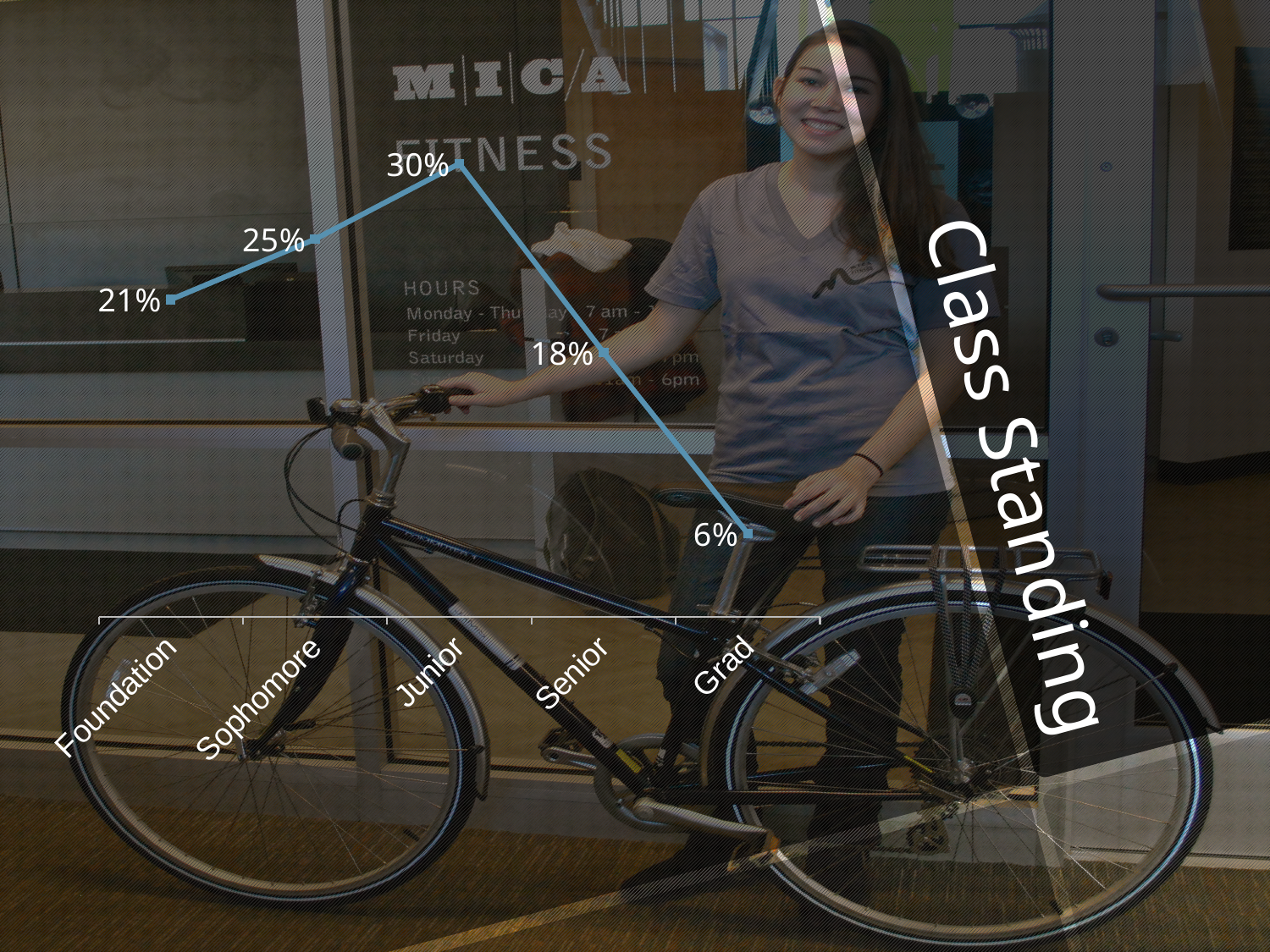
What is the value for Senior? 18% Which is larger, the value for Foundation or the value for Senior? Foundation What is the title of the chart? Class Standing What is the value for Foundation? 21% What is the value for Sophomore? 25% What is the value for Junior? 30% How many categories are plotted on the x axis? 5 Which class standing has the lowest value? Grad Which class standing has the highest value? Junior What kind of chart is shown on the slide? Line chart What is the difference between the values for Junior and Senior? 12% What is the value for Grad? 6%